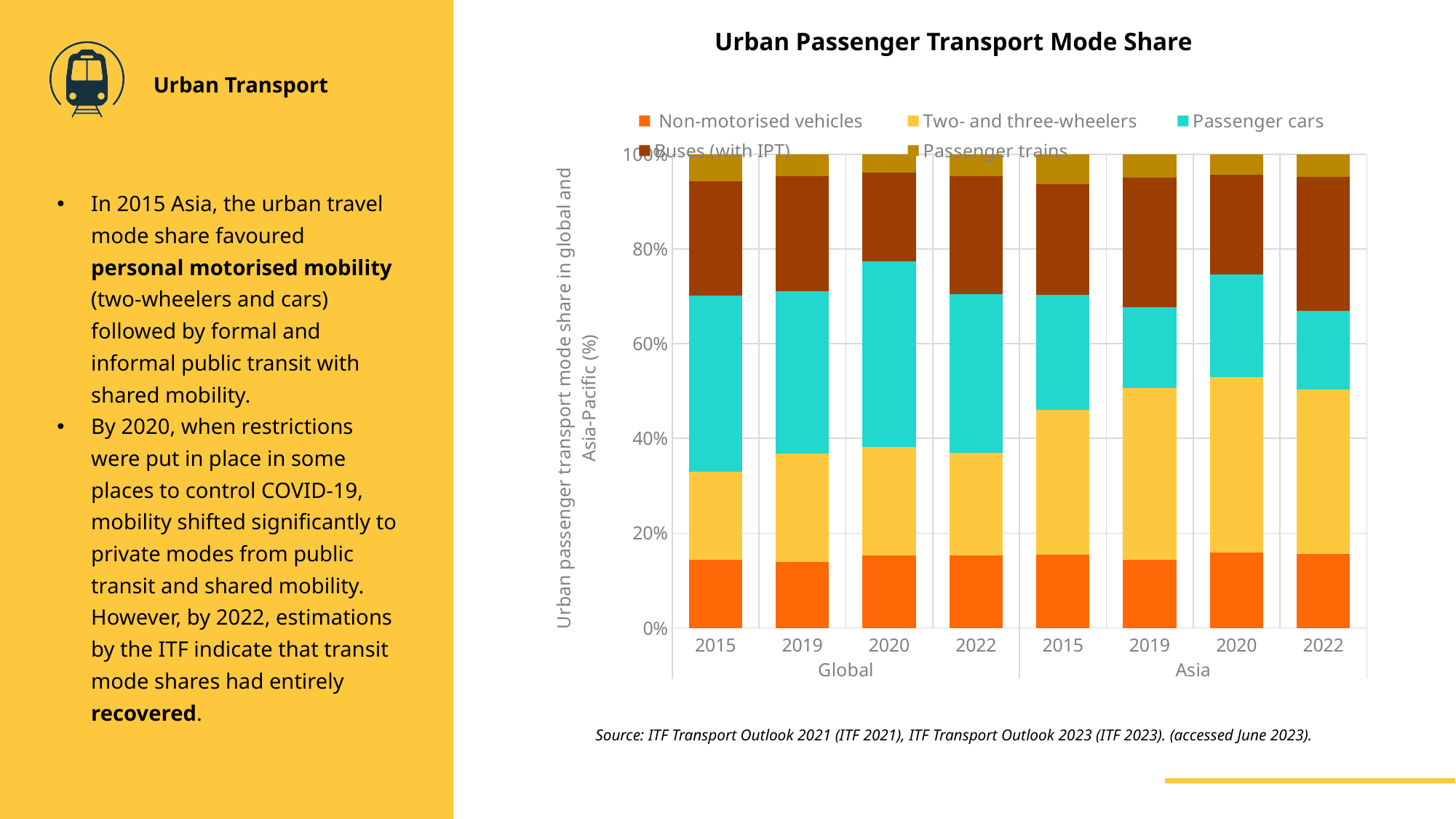
How many bars are plotted in the Urban Passenger Transport Mode Share chart? 8 What is the total of the stacked bar for Asia 2022? 100% Which two regions are shown on the x axis of the chart? Global and Asia Is the Buses (with IPT) share for Asia 2022 greater or less than 20%? greater Is the Non-motorised vehicles share for Global 2015 greater or less than 20%? less What kind of chart is shown on the slide? Stacked bar chart What is the title of the chart on the slide? Urban Passenger Transport Mode Share Is the Passenger trains share for Global 2015 greater or less than 20%? less In 2020, which region has the larger Passenger cars share, Global or Asia? Global How many series does the legend of the Urban Passenger Transport Mode Share chart list? 5 In 2020, which region has the larger Two- and three-wheelers share, Global or Asia? Asia